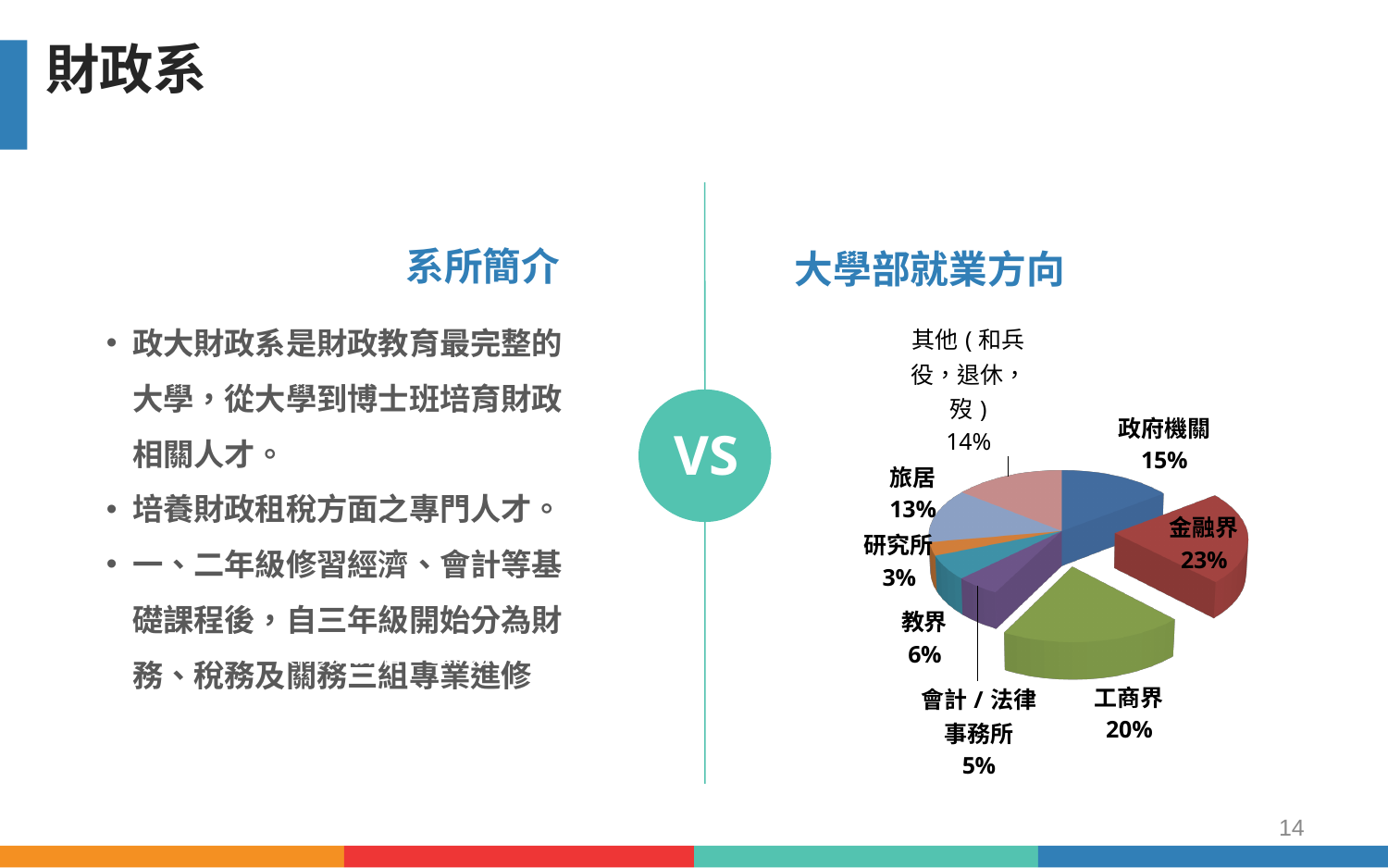
What percentage of the pie chart is 金融界? 23% What percentage of the pie chart is 研究所? 3% Which is larger in the pie chart, 旅居 or 教界? 旅居 How many categories are shown in the pie chart? 8 What is the difference in percentage points between 金融界 and 工商界? 3% What percentage of the pie chart is 其他 (和兵役，退休，歿)? 14% What is the title of the pie chart? 大學部就業方向 What percentage of the pie chart is 政府機關? 15% Which category has the smallest share of the pie chart? 研究所 What percentage of the pie chart is 工商界? 20% Which category has the largest share of the pie chart? 金融界 What kind of chart is shown under 大學部就業方向? Pie chart